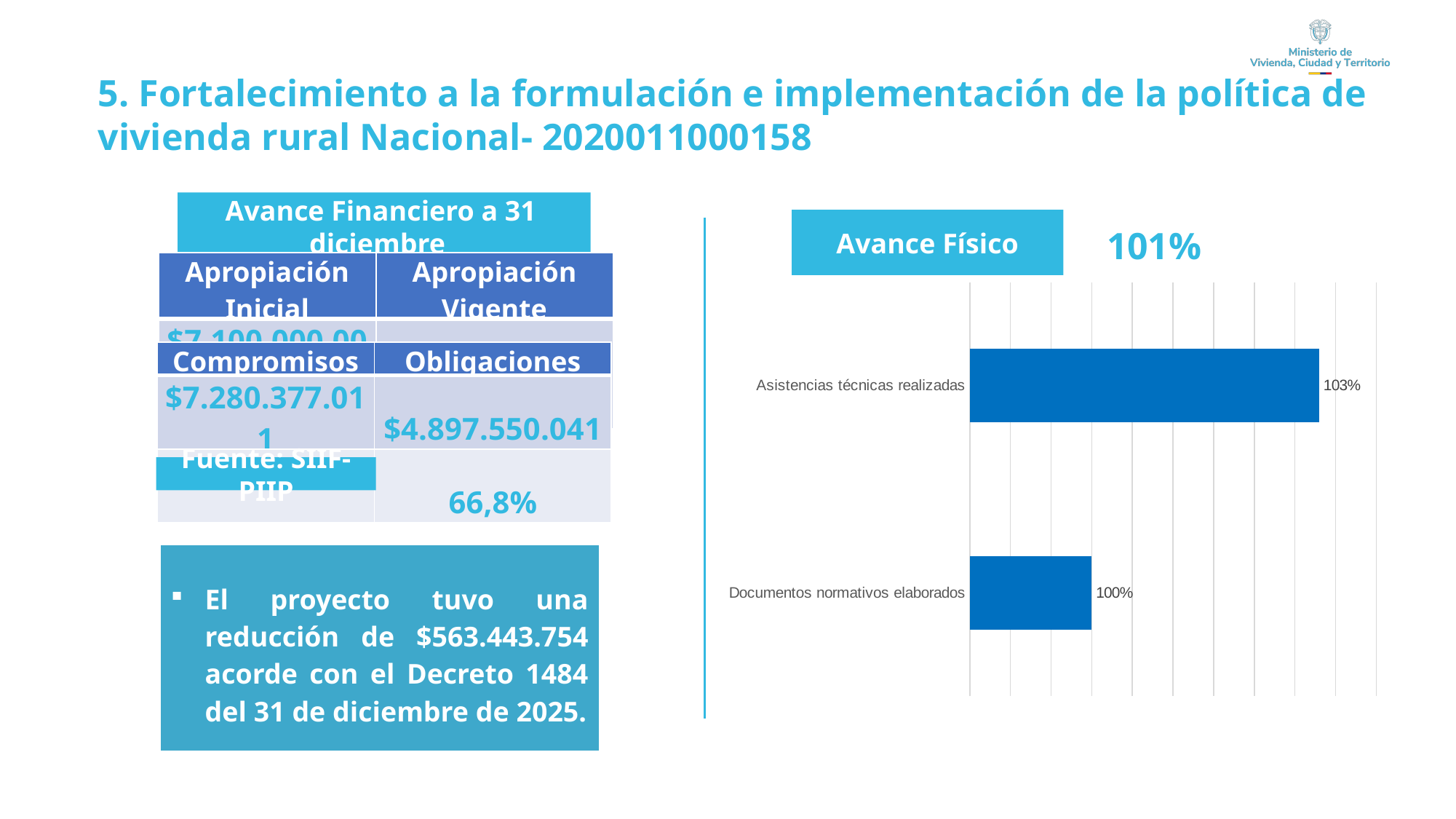
What overall percentage is displayed next to the chart title? 101% Which category has the highest value in the chart? Asistencias técnicas realizadas Which category has the lowest value in the chart? Documentos normativos elaborados What kind of chart is shown on the slide? Bar chart What is the value for Documentos normativos elaborados? 100% What is the title shown above the chart? Avance Físico Which is larger: the value for Asistencias técnicas realizadas or for Documentos normativos elaborados? Asistencias técnicas realizadas How many categories are shown in the chart? 2 What is the difference between the values for Asistencias técnicas realizadas and Documentos normativos elaborados? 3% What is the value for Asistencias técnicas realizadas? 103%